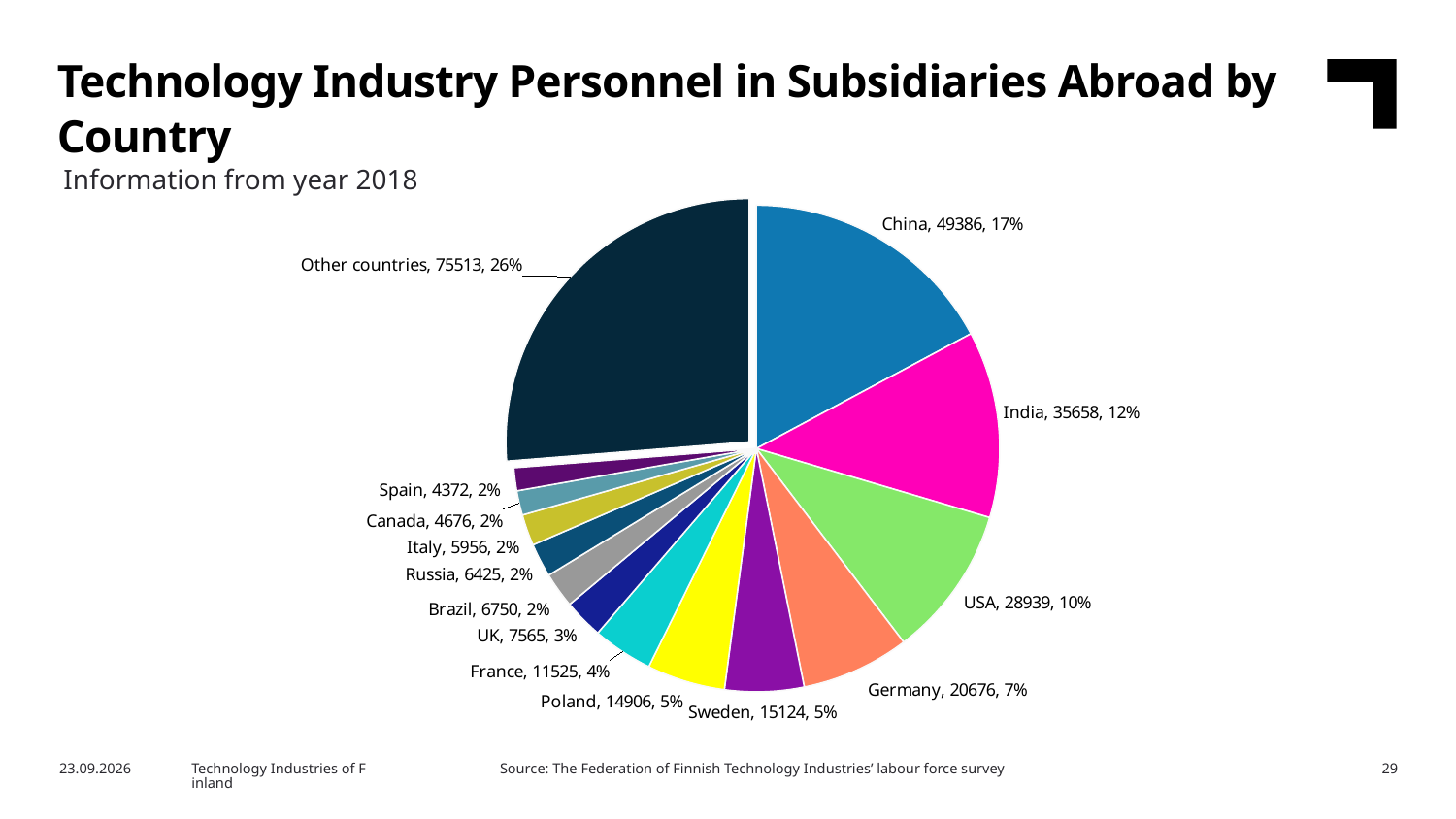
What is the personnel value for Poland? 14906 What is the combined personnel of Sweden and Poland? 30030 Which slice of the pie is the smallest? Spain Which has more personnel, Germany or USA? USA What share of the pie does India represent? 12% How many slices does the pie chart have? 14 What type of chart is shown on the slide? Pie chart What is the number of personnel in subsidiaries in China? 49386 What is the difference in personnel between China and India? 13728 Which named country (excluding 'Other countries') has the largest slice? China What year does the chart's information come from? 2018 What percentage share is labelled for 'Other countries'? 26%